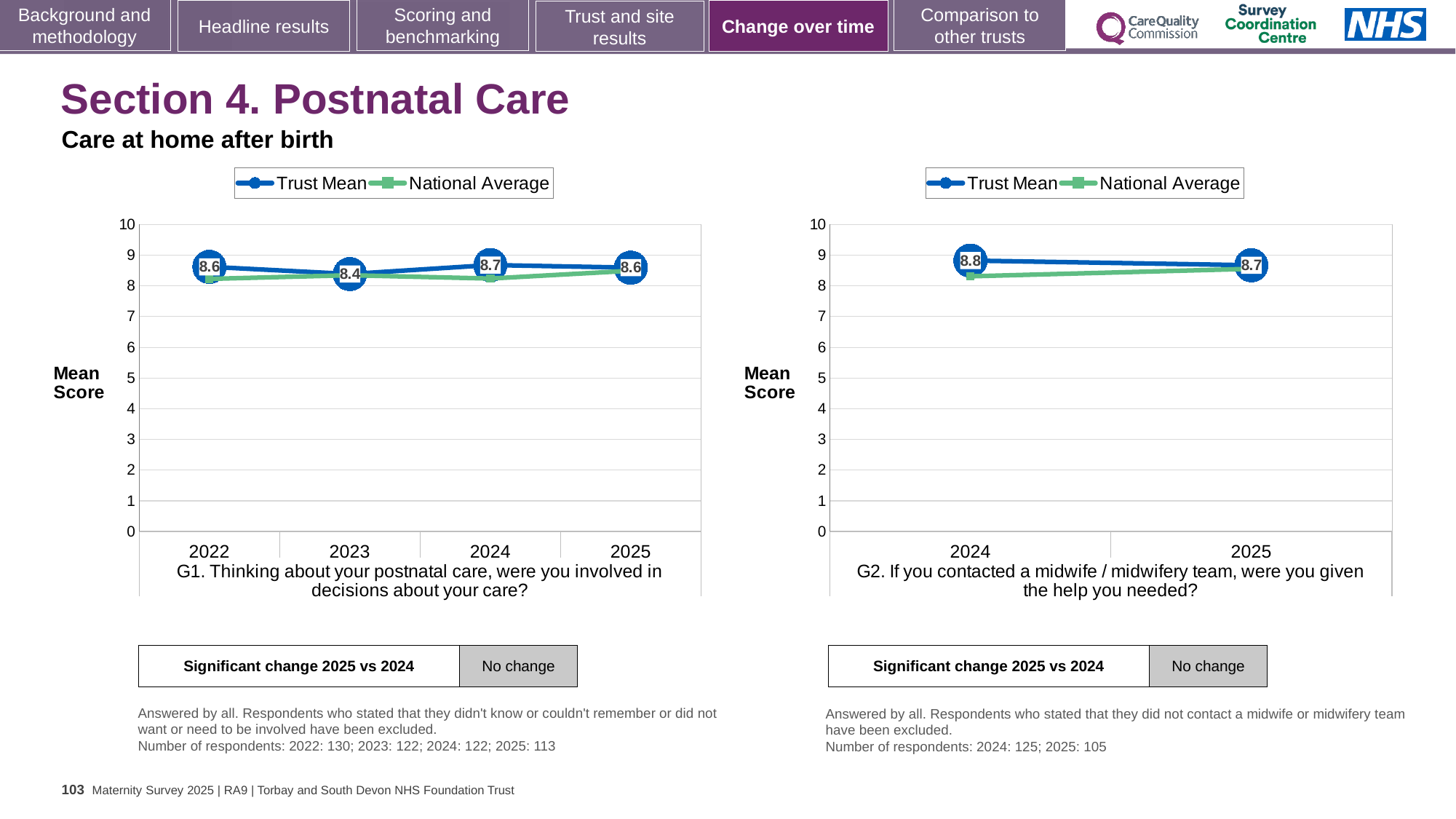
On the left chart (G1), is the Trust Mean higher in 2024 or in 2023? 2024 On the right chart (G2), what is the difference between the Trust Mean in 2024 and in 2025? 0.1 On the left chart (G1), what is the Trust Mean for 2024? 8.7 On the right chart (G2), is the National Average for 2024 greater or less than 9? less On the left chart (G1), which year has the lowest Trust Mean? 2023 What kind of chart is the left chart (G1)? line chart On the left chart (G1), which year has the highest Trust Mean? 2024 How many series does the legend of the right chart (G2) list? 2 On the left chart (G1), what is the Trust Mean for 2023? 8.4 On the left chart (G1), what is the Trust Mean for 2022? 8.6 How many years are shown on the x axis of the left chart (G1)? 4 On the right chart (G2), what is the Trust Mean for 2025? 8.7